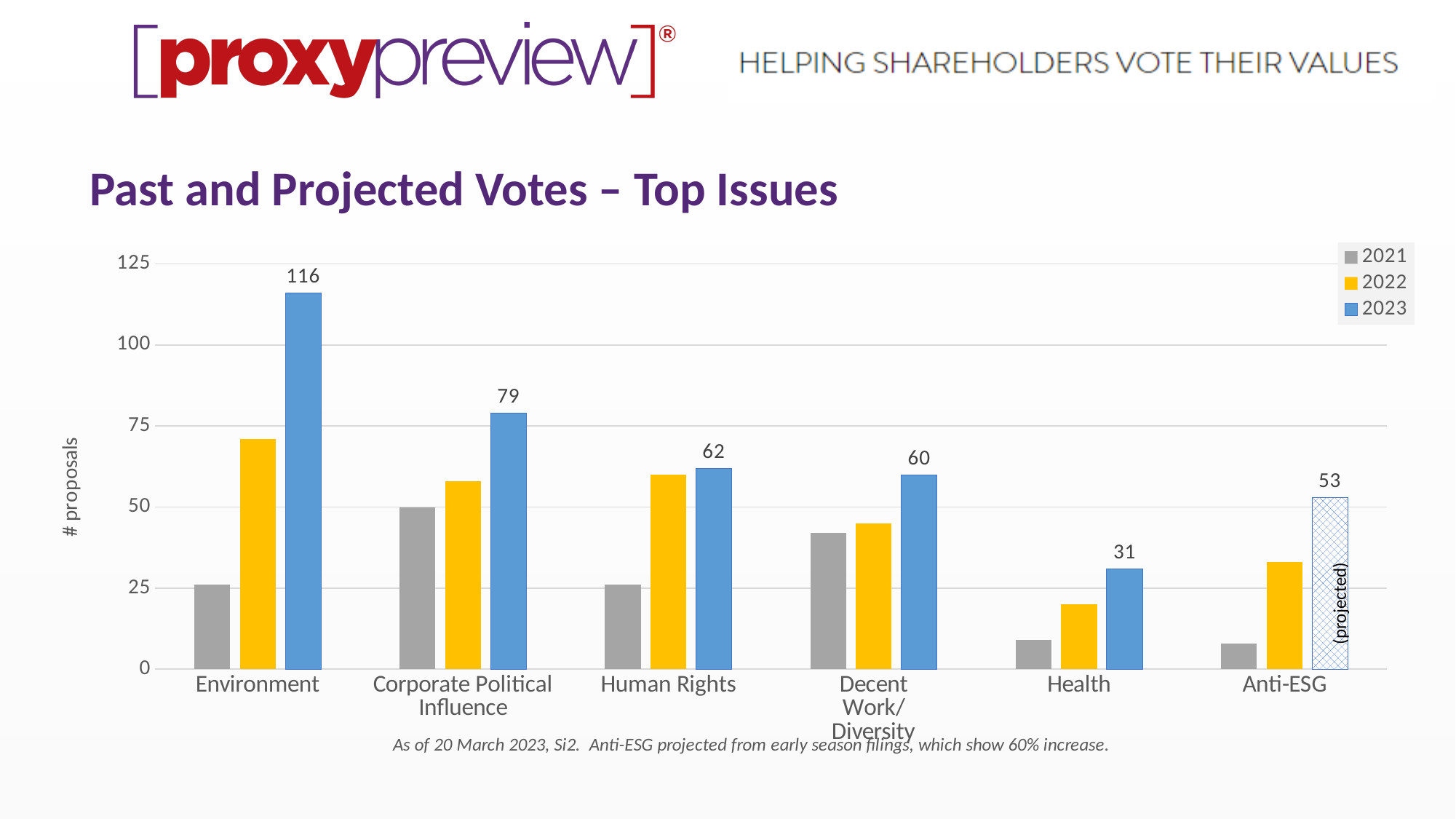
Which is larger in 2023: Human Rights or Decent Work/Diversity? Human Rights What is the 2023 value for Corporate Political Influence? 79 How many series does the legend list? 3 How many issue categories are shown on the x axis? 6 What is the difference between the 2023 values for Environment and Corporate Political Influence? 37 What kind of chart is shown on the slide? bar chart What is the 2023 value for Environment? 116 Which issue has the lowest 2023 value? Health Is the 2022 value for Environment greater or less than 50? greater Which issue has the highest 2023 value? Environment What is the projected 2023 value for Anti-ESG? 53 Is the 2021 value for Health greater or less than 25? less